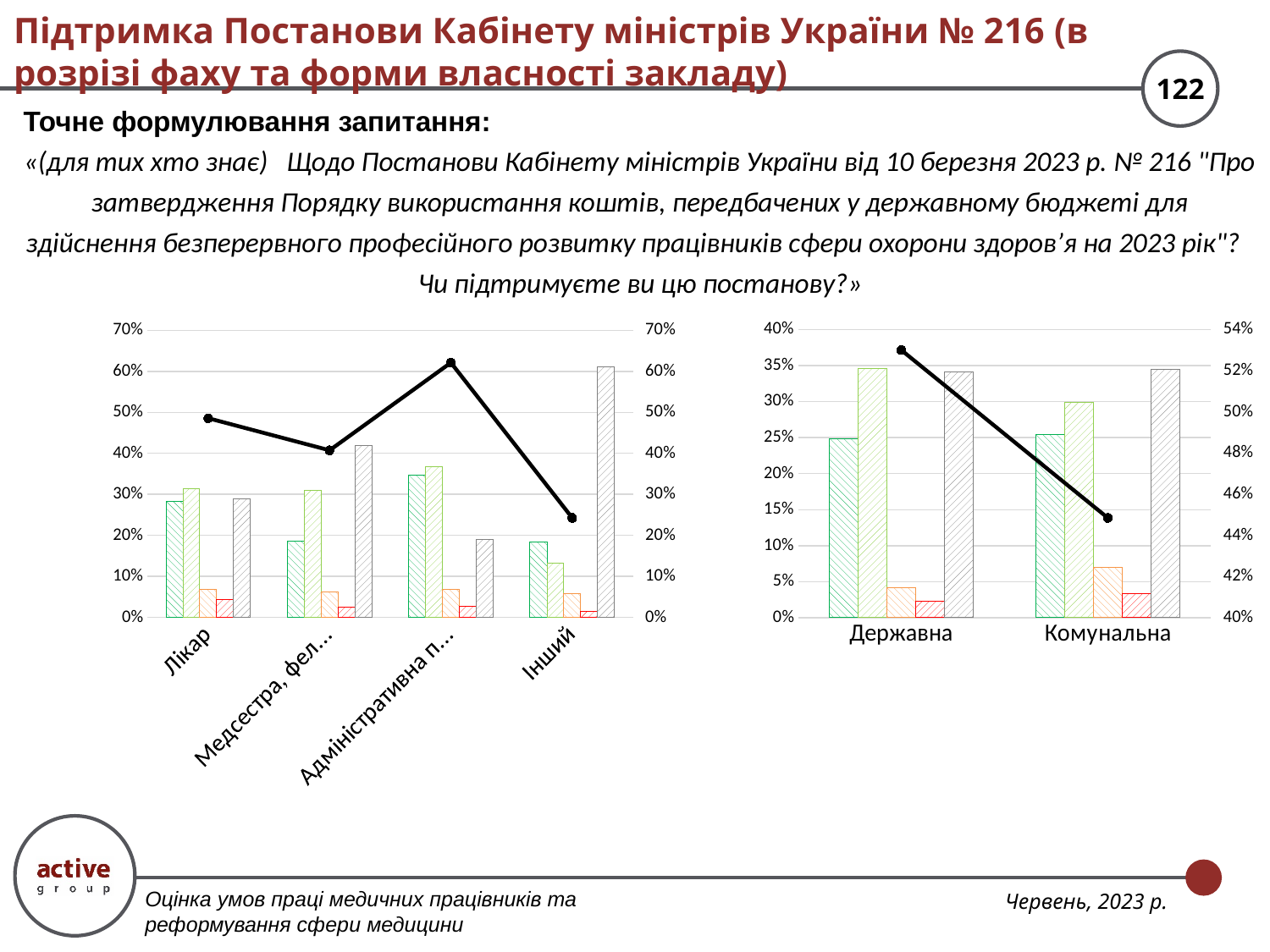
On the right chart, is the line value for Комунальна greater or less than 50%? less On the right chart, how many categories are shown on the x axis? 2 On the right chart, is the line value for Державна or for Комунальна larger? Державна What kind of chart is the left chart? Combined bar and line chart On the left chart, is the tallest bar for Інший greater or less than 50%? greater On the right chart, does the line rise or fall from Державна to Комунальна? falls On the left chart, is the line value for Інший greater or less than 30%? less On the left chart, is the line value for Лікар or for Інший larger? Лікар On the left chart, which category has the lowest line value? Інший On the left chart, how many categories are shown on the x axis? 4